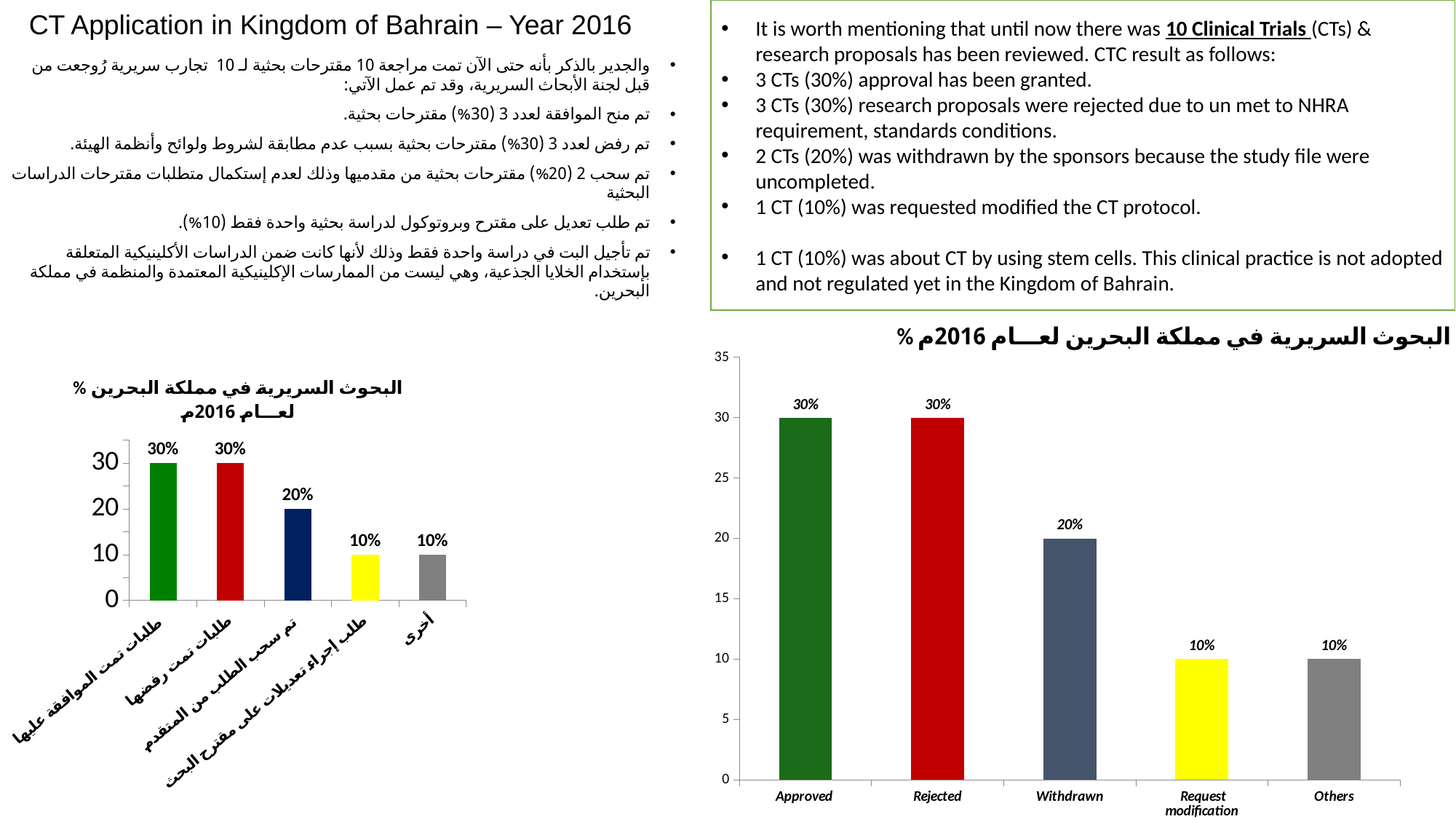
In the right-hand chart, what is the value for Approved? 30% In the right-hand chart, what is the difference between the values for Approved and Others? 20% In the right-hand chart, what is the value for Request modification? 10% In the right-hand chart, what is the value for Withdrawn? 20% In the right-hand chart, which category has the lowest value, Withdrawn or Others? Others In the right-hand chart, is the value for Withdrawn greater or less than 15? greater In the right-hand chart, what colour is the bar for Rejected? red In the right-hand chart, what is the difference between the values for Rejected and Withdrawn? 10% In the right-hand chart, do the values rise or fall from Approved to Others along the x axis? fall In the right-hand chart, how many categories are shown on the x axis? 5 In the left-hand chart, what is the value for the category أخرى? 10% What kind of chart is the right-hand chart? bar chart